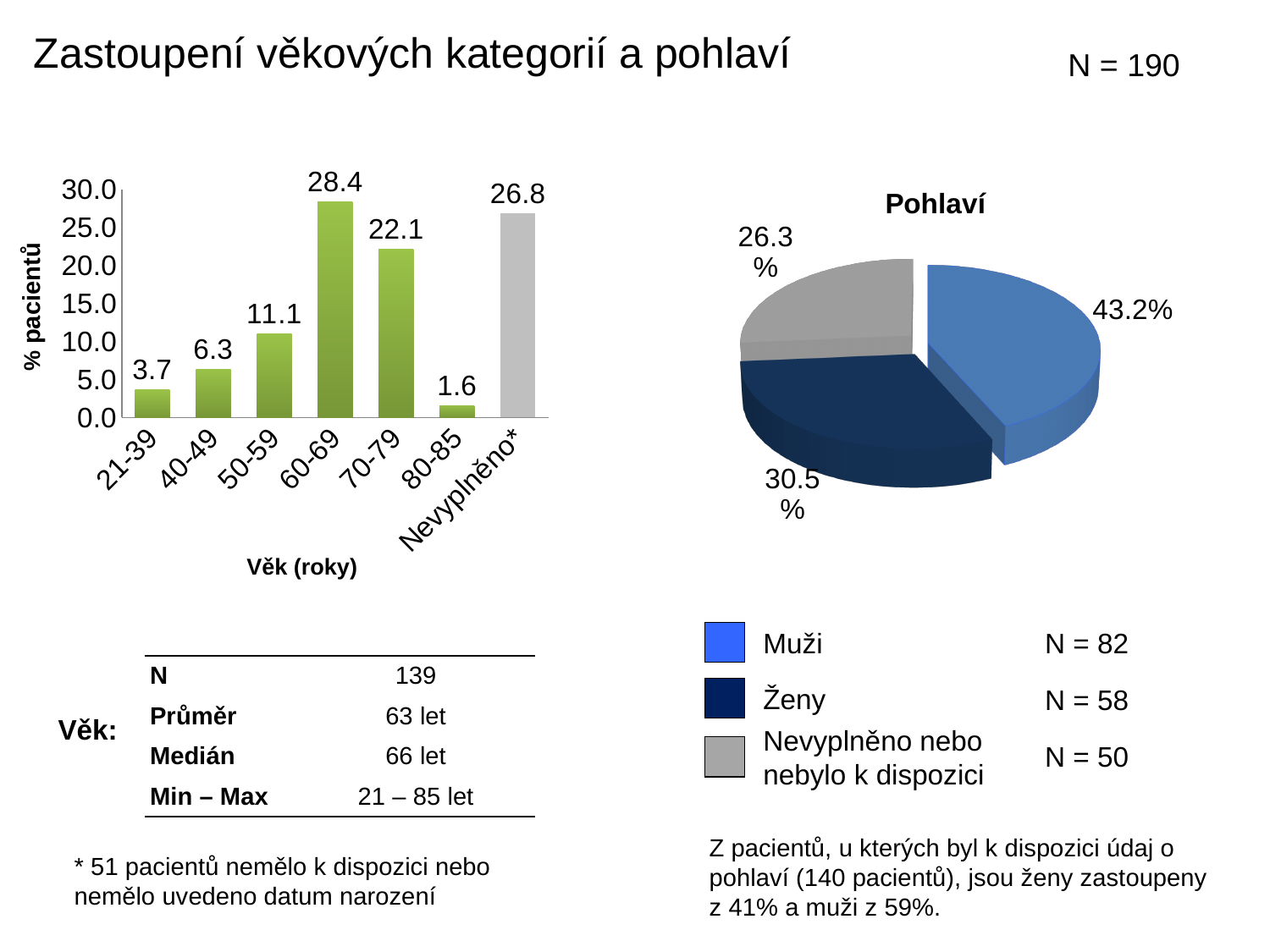
In the pie chart titled Pohlaví, what share of the pie is labelled 43.2%? Muži In the bar chart on the left, what is the difference between the values for 60-69 and 70-79? 6.3 How many entries does the legend of the pie chart titled Pohlaví list? 3 In the pie chart titled Pohlaví, what is the percentage for Ženy? 30.5% What type of chart is the chart on the left of the slide? bar chart In the pie chart titled Pohlaví, which slice is the largest? Muži How many categories are shown on the x axis of the bar chart on the left? 7 In the bar chart on the left, which category has the lowest value? 80-85 In the bar chart on the left, what is the value for the 21-39 age category? 3.7 In the bar chart on the left, which age category has the highest percentage of patients? 60-69 In the bar chart on the left, what percentage of patients are in the 60-69 age category? 28.4 In the bar chart on the left, which is larger: the value for 50-59 or the value for 40-49? 50-59